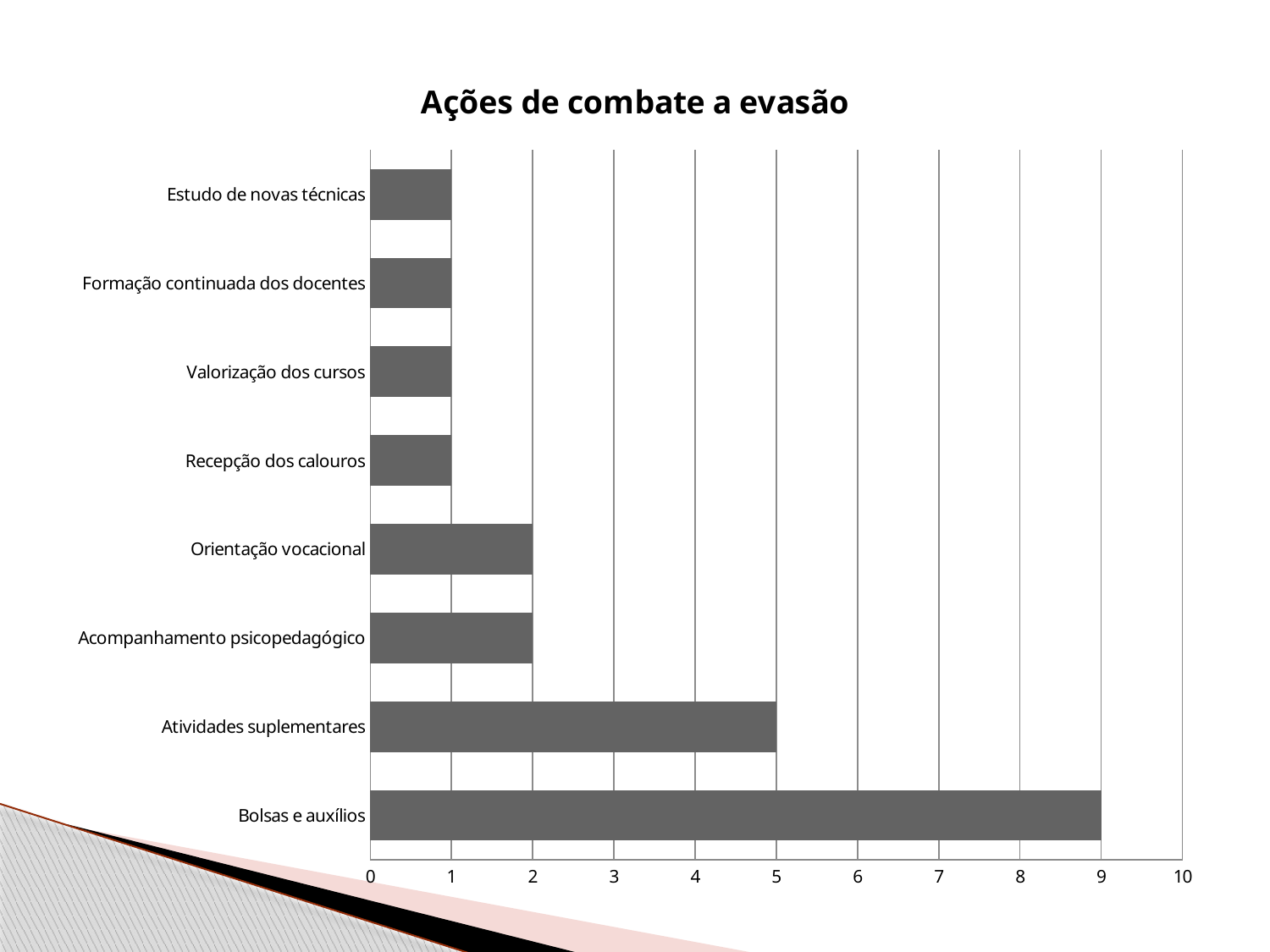
What is the value for Recepção dos calouros? 1 How many categories are shown in the chart? 8 Is the value for Bolsas e auxílios greater or less than 8? greater What is the value for Orientação vocacional? 2 Which is larger, the value for Atividades suplementares or the value for Orientação vocacional? Atividades suplementares What kind of chart is shown on the slide? Bar chart Which category has the highest value? Bolsas e auxílios What is the value for Atividades suplementares? 5 What is the difference between the values for Bolsas e auxílios and Atividades suplementares? 4 What is the value for Bolsas e auxílios? 9 What is the title of the chart? Ações de combate a evasão What is the difference between the values for Atividades suplementares and Acompanhamento psicopedagógico? 3